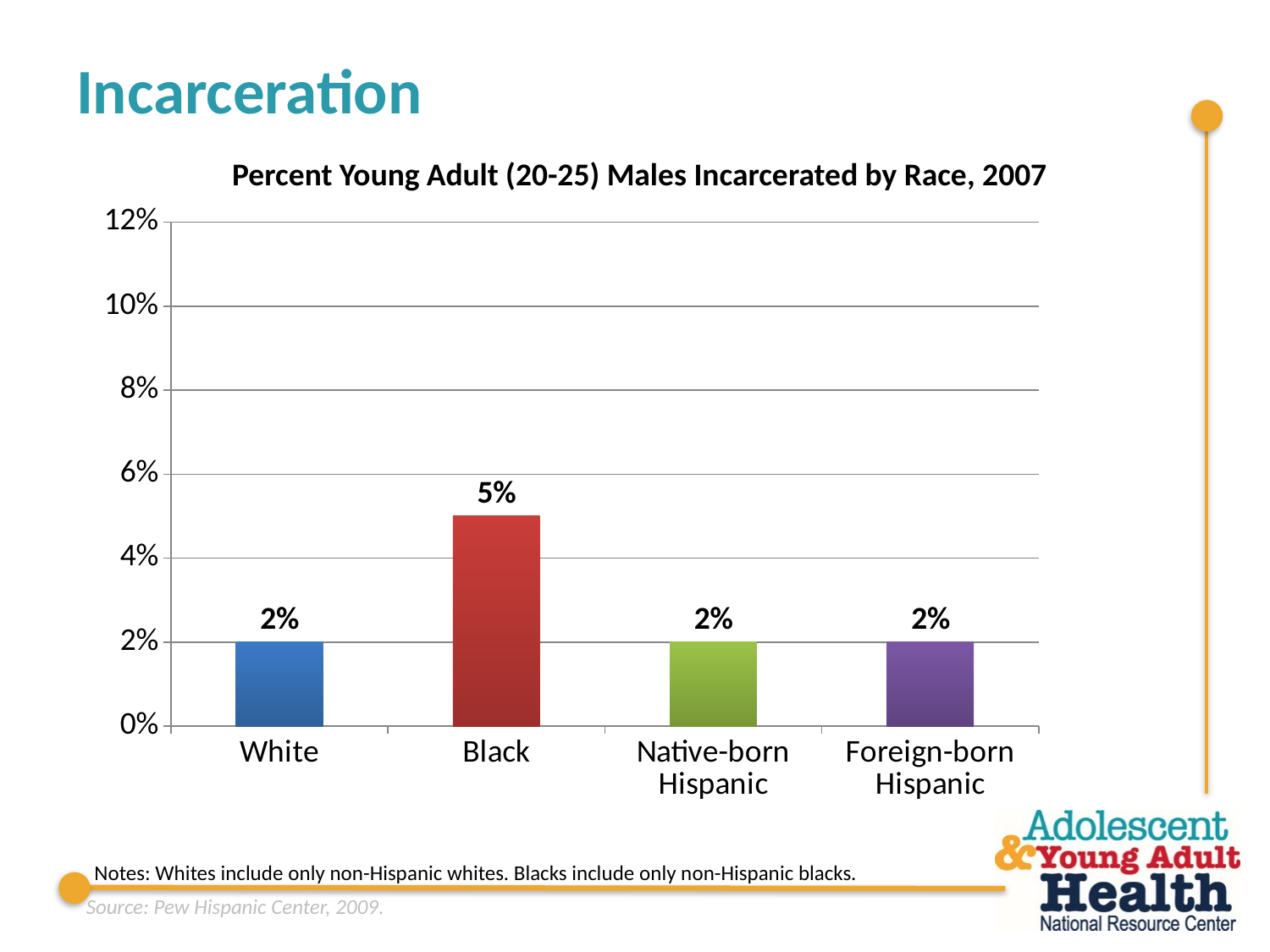
What is the value for White? 2% Which is larger, the value for Black or the value for Foreign-born Hispanic? Black Is the value for Black greater or less than 4%? greater What is the value for Black? 5% What colour is the bar for Black? red What is the value for Native-born Hispanic? 2% What is the title of the chart? Percent Young Adult (20-25) Males Incarcerated by Race, 2007 How many categories are shown on the x axis? 4 What is the value for Foreign-born Hispanic? 2% What is the difference between the values for Black and White? 3% What kind of chart is shown on the slide? bar chart Which category has the highest value? Black